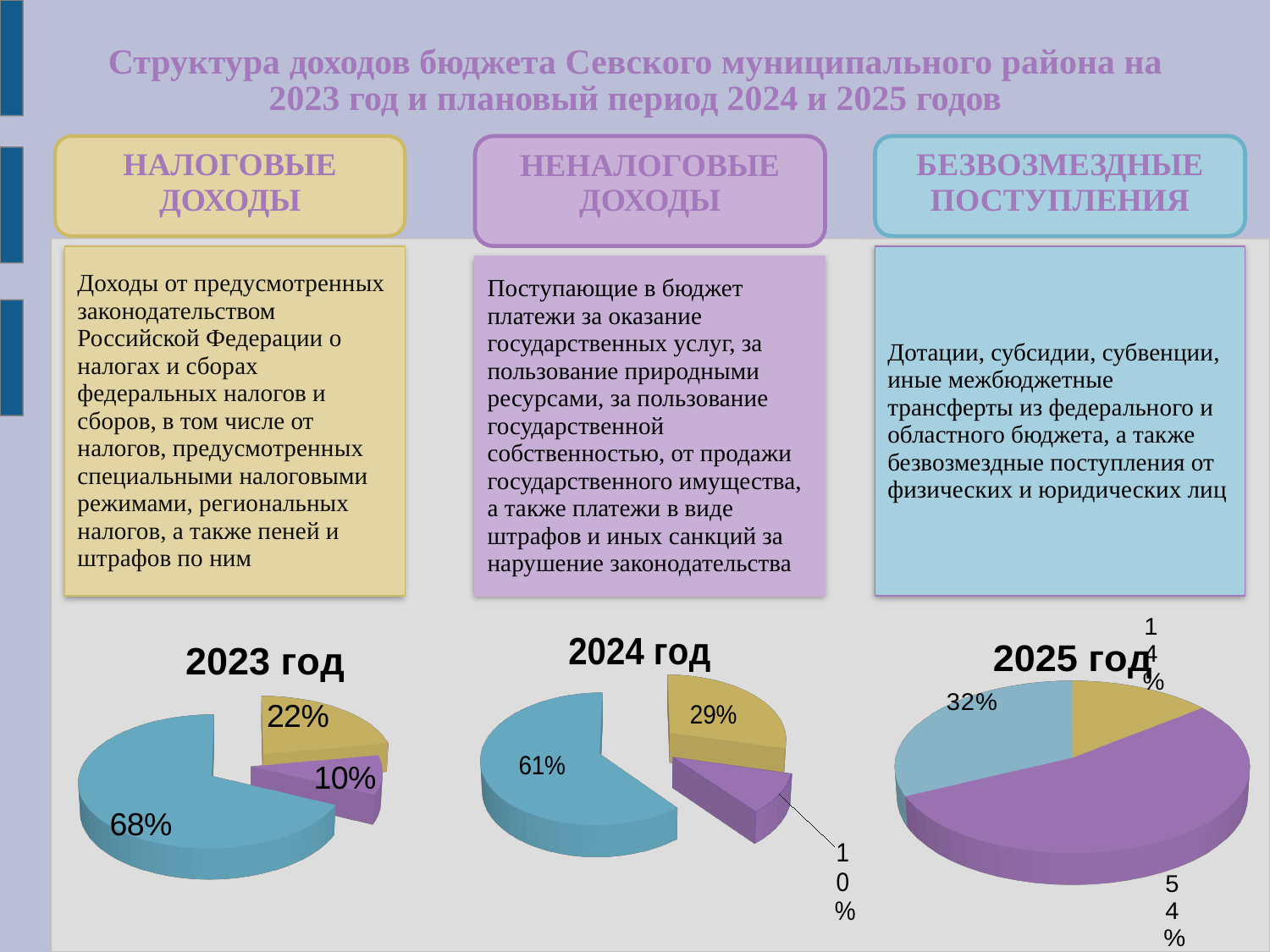
How many pie charts are shown on the slide? 3 What is the difference between the blue slice in the 2023 год chart and the blue slice in the 2025 год chart? 36% What kind of chart is used for the 2023 год chart? pie chart How many slices does the 2024 год chart have? 3 In the 2023 год chart, what is the value of the smallest slice? 10% In the 2024 год chart, what is the value of the blue slice? 61% In the 2025 год chart, which slice is the smallest? the yellow slice (14%) In the 2023 год chart, what is the value of the largest slice? 68% In the 2024 год chart, what is the difference between the yellow slice and the purple slice? 19% In the 2023 год chart, what is the value of the yellow slice? 22% In the 2025 год chart, what is the value of the purple slice? 54% In the 2025 год chart, which is larger, the blue slice or the purple slice? the purple slice